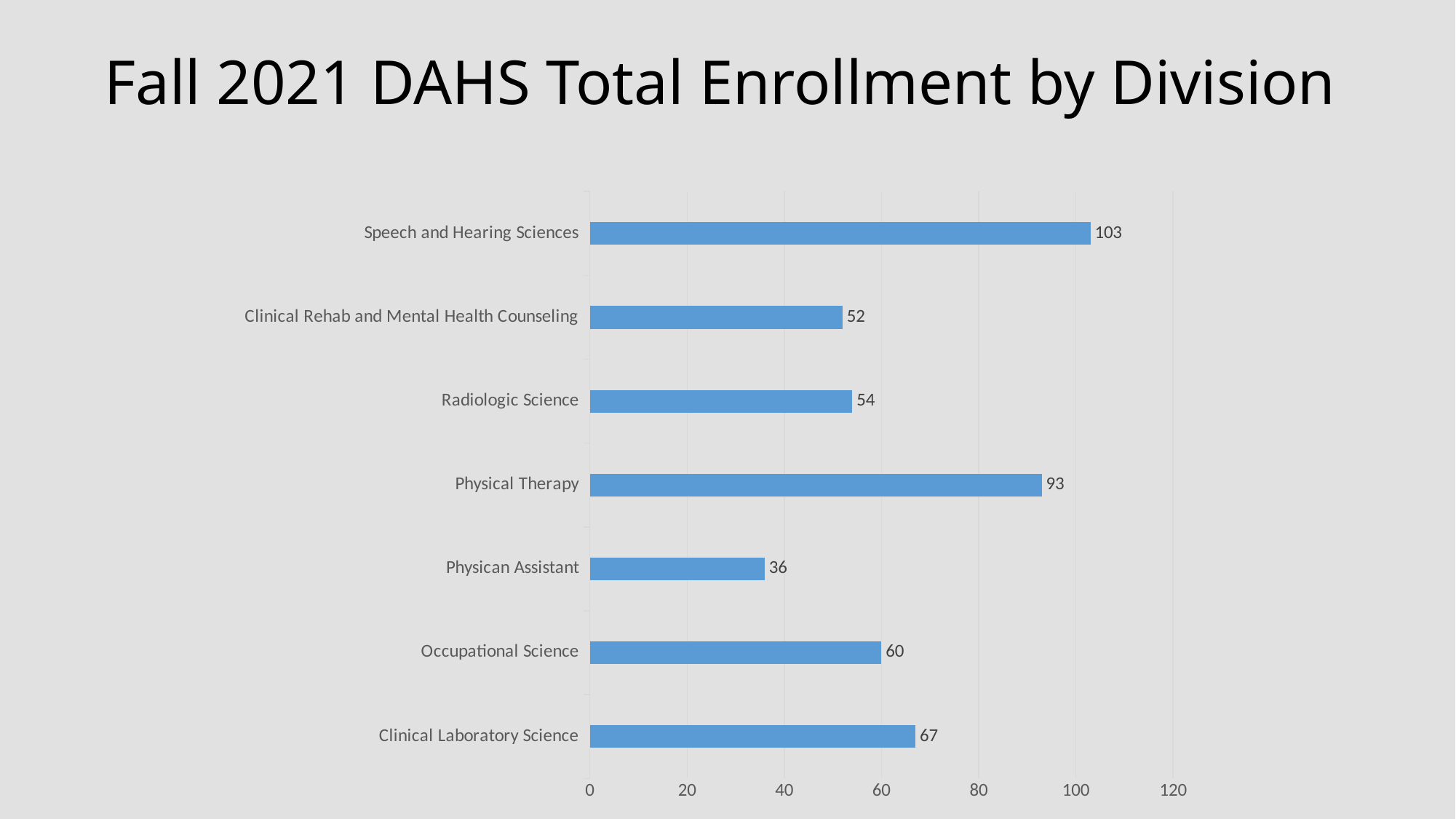
Which has higher enrollment, Occupational Science or Radiologic Science? Occupational Science Is the value for Physical Therapy greater or less than 80? greater What is the enrollment for Physican Assistant? 36 What is the enrollment for Clinical Laboratory Science? 67 How many divisions are shown in the chart? 7 What is the difference in enrollment between Clinical Laboratory Science and Occupational Science? 7 What is the difference in enrollment between Speech and Hearing Sciences and Physical Therapy? 10 Which division has the highest enrollment? Speech and Hearing Sciences What kind of chart is shown on the slide? Bar chart Which division has the lowest enrollment? Physican Assistant What is the enrollment for Speech and Hearing Sciences? 103 What is the enrollment for Physical Therapy? 93